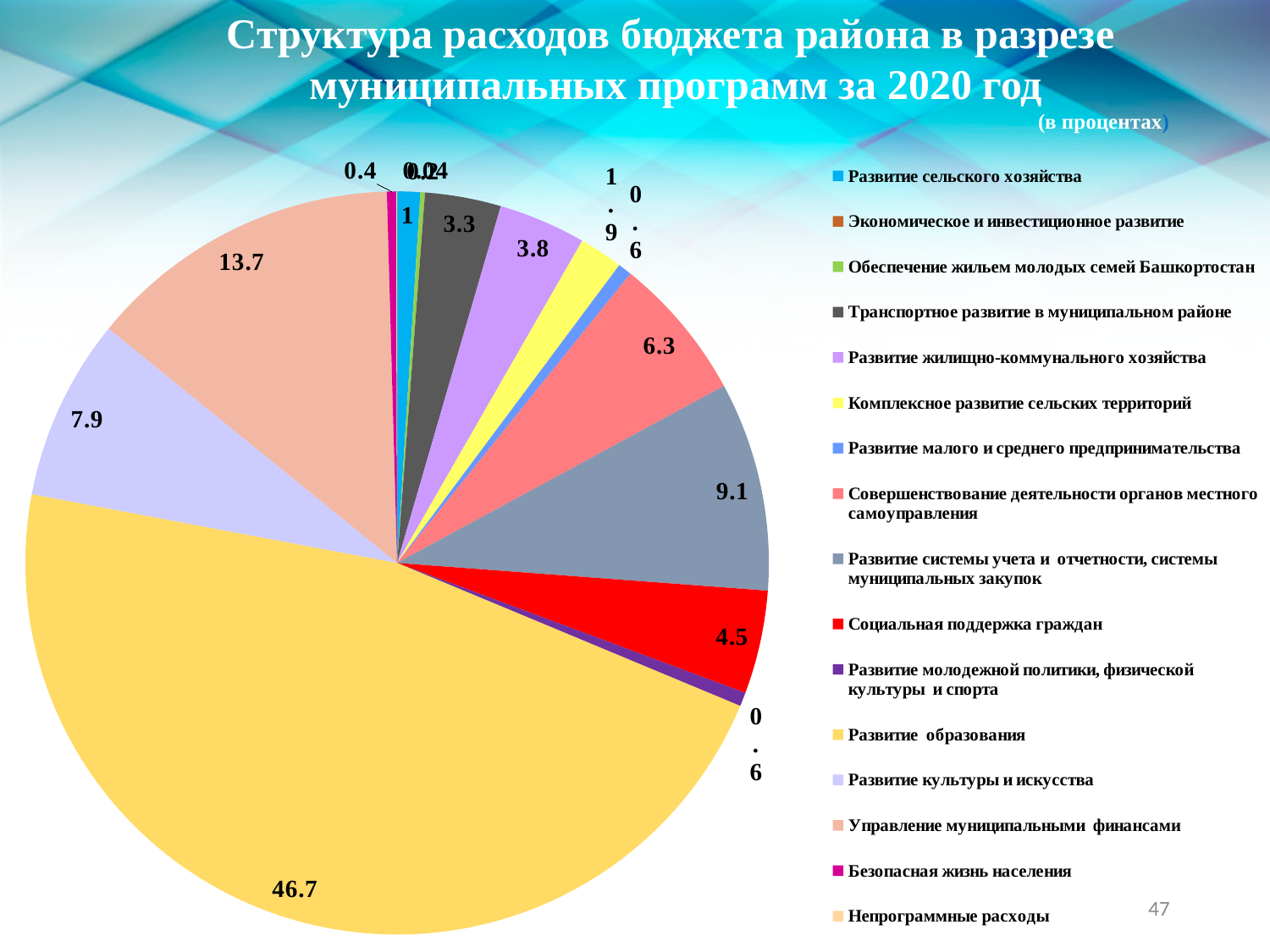
What is the share for Развитие образования? 46.7 Which is larger: the share for Совершенствование деятельности органов местного самоуправления or the share for Развитие жилищно-коммунального хозяйства? Совершенствование деятельности органов местного самоуправления What kind of chart is shown on the slide? pie chart What is the difference between the shares for Развитие образования and Управление муниципальными финансами? 33.0 What is the share for Развитие системы учета и отчетности, системы муниципальных закупок? 9.1 How many entries does the legend list? 16 What is the share for Развитие культуры и искусства? 7.9 What is the share for Управление муниципальными финансами? 13.7 What is the share for Социальная поддержка граждан? 4.5 Which municipal program has the largest share of the district budget expenditures? Развитие образования What is the share for Транспортное развитие в муниципальном районе? 3.3 In what units are the values of the chart expressed, according to the note under the title? в процентах